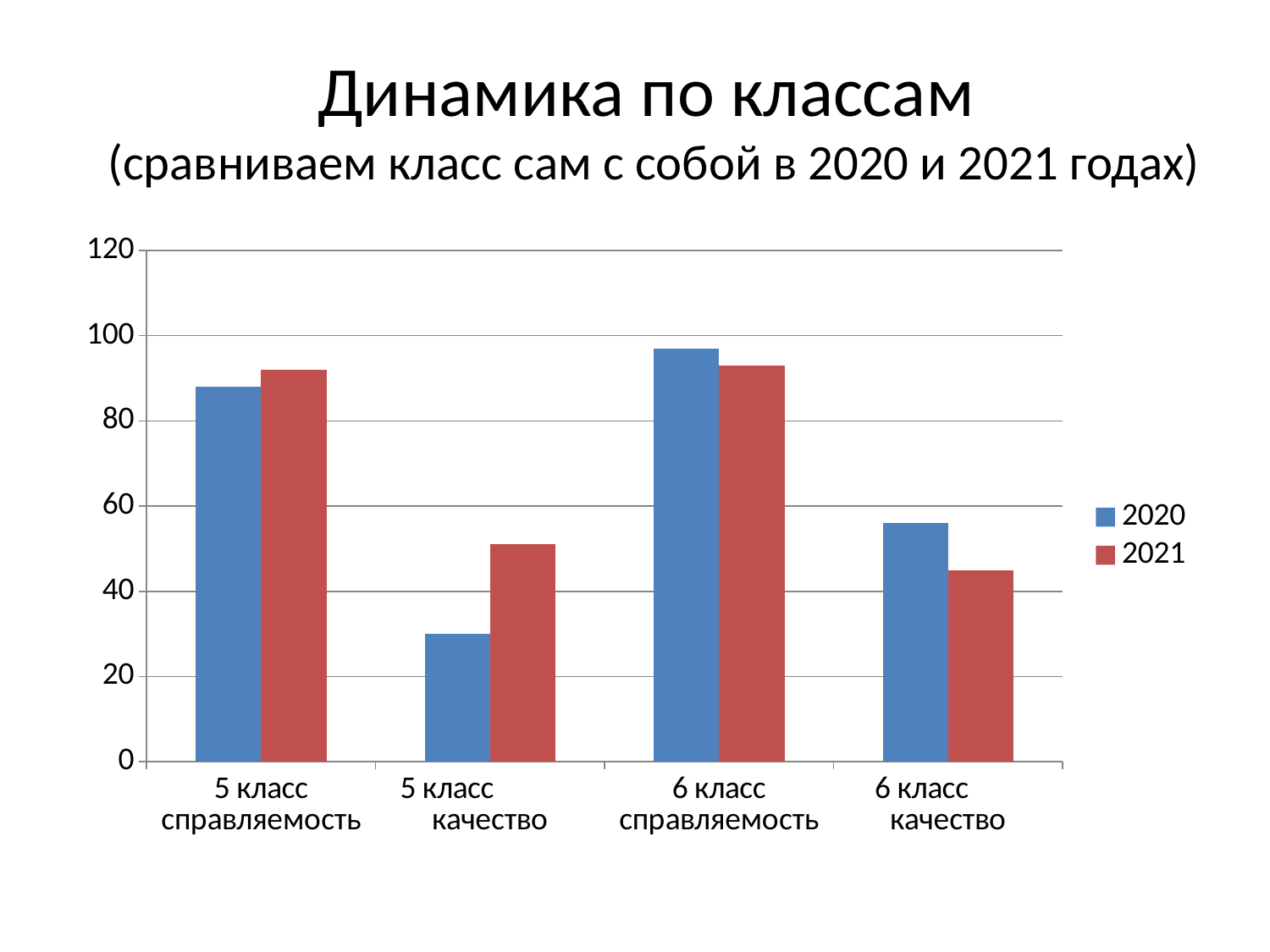
Is the 2020 value for 6 класс справляемость greater or less than 80? greater For 5 класс качество, which series has the larger value, 2020 or 2021? 2021 What kind of chart is shown on the slide? bar chart For 6 класс качество, which series has the larger value, 2020 or 2021? 2020 Which series is shown in red in the legend? 2021 Which category has the lowest value for the 2021 series? 6 класс качество Is the 2020 value for 5 класс качество greater or less than 40? less Which category has the highest value for the 2020 series? 6 класс справляемость How many categories are shown on the x axis? 4 Which category has the lowest value for the 2020 series? 5 класс качество How many series does the legend list? 2 Is the 2021 value for 5 класс качество greater or less than 40? greater